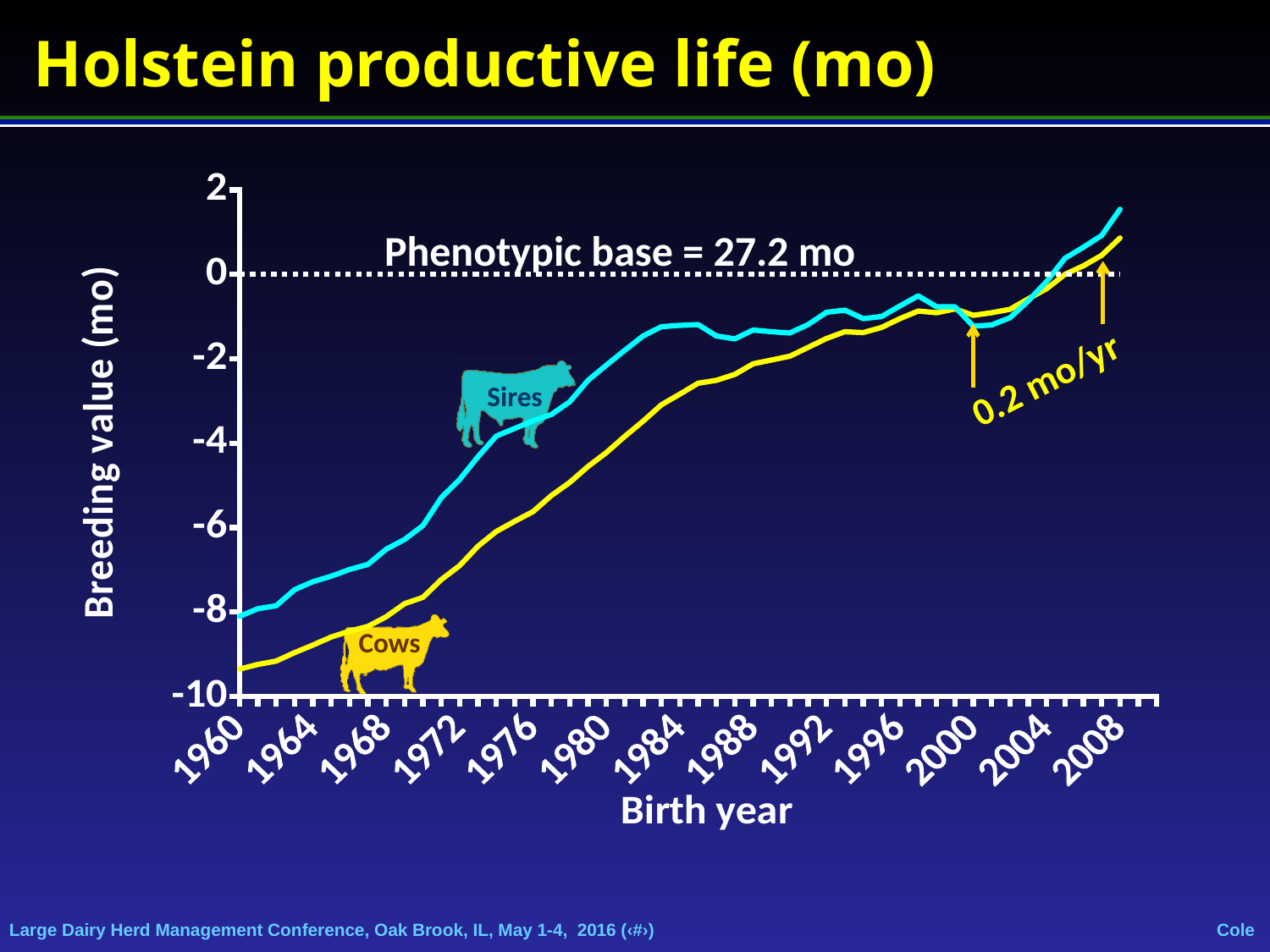
Is the breeding value for Cows in 1960 greater or less than -8? less What kind of chart is shown on the slide? line chart In 1968, which series has the lower breeding value, Sires or Cows? Cows What is the phenotypic base value stated on the chart? 27.2 mo Is the breeding value for Cows in 1996 greater or less than -2? greater Do the breeding values for Sires rise or fall from 1960 to 2008? rise How many series are plotted on the chart? 2 In 1980, which series has the higher breeding value, Sires or Cows? Sires Is the breeding value for Sires in 2008 greater or less than 0? greater Do the breeding values for Cows rise or fall from 1960 to 2008? rise What are the names of the two series plotted on the chart? Sires and Cows